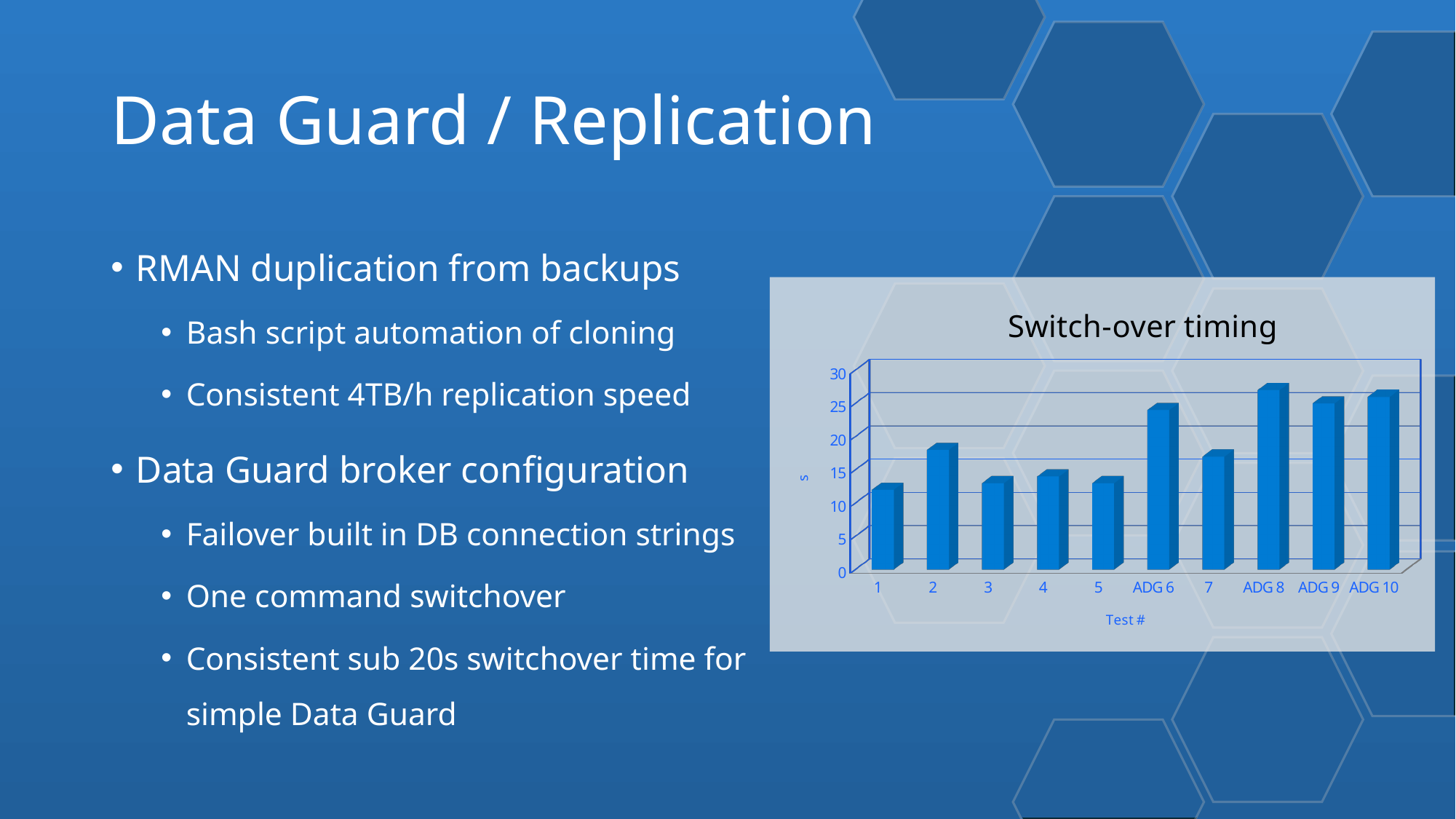
Is the value for test 1 greater or less than 15? less Is the value for test 7 greater or less than 20? less Is the value for ADG 9 greater or less than 20? greater What is the title of the chart on the slide? Switch-over timing Which has a higher value, ADG 6 or test 7? ADG 6 How many test categories are shown on the x axis of the chart? 10 Which has a higher value, test 2 or test 1? test 2 What kind of chart is shown on the slide? bar chart What is the x-axis title of the chart? Test #